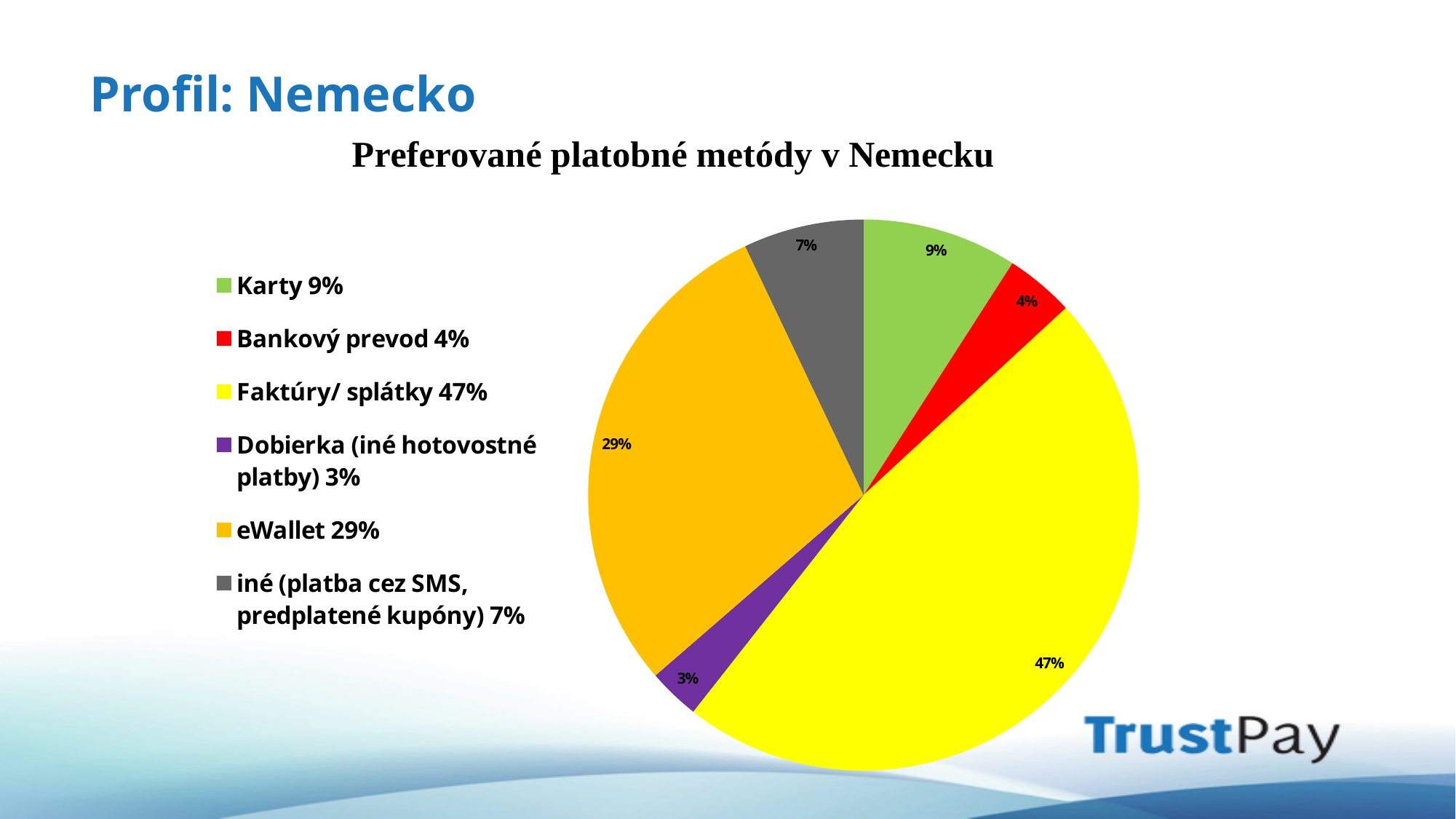
What share of the pie does Faktúry/ splátky have? 47% What colour is the slice for eWallet? orange What is the value for eWallet? 29% What type of chart is shown on the slide? pie chart Which is larger, the share for Karty or the share for iné (platba cez SMS, predplatené kupóny)? Karty What is the value for Karty? 9% How many categories does the pie chart have? 6 Which payment method has the largest slice? Faktúry/ splátky What is the title of the chart? Preferované platobné metódy v Nemecku What is the difference between the shares of Faktúry/ splátky and eWallet? 18% Which payment method has the smallest slice? Dobierka (iné hotovostné platby) What is the value for Bankový prevod? 4%